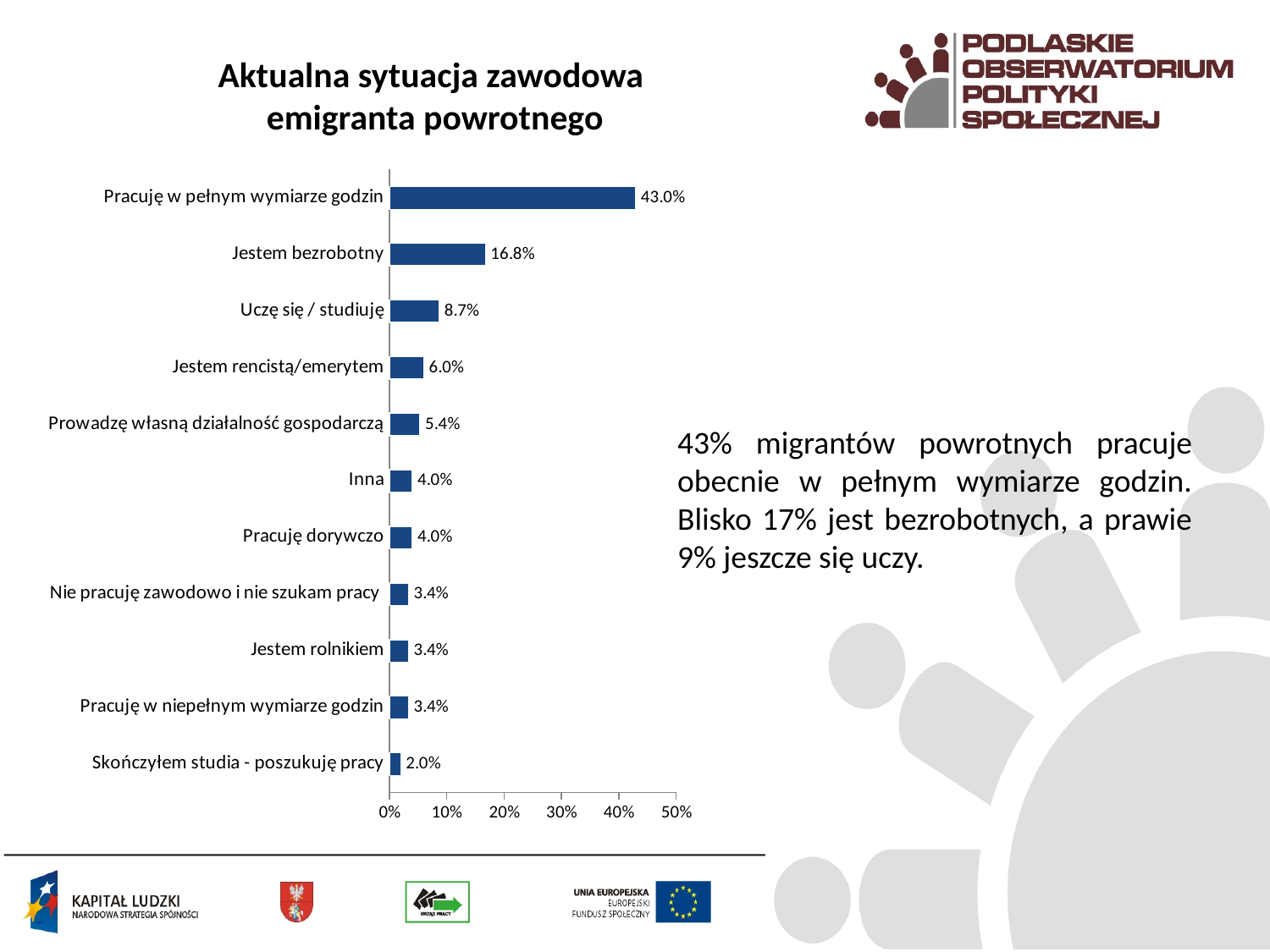
What is the value for "Prowadzę własną działalność gospodarczą"? 5.4% Is the value for "Jestem bezrobotny" greater or less than 20%? less What is the value for "Uczę się / studiuję"? 8.7% What is the value for "Jestem bezrobotny"? 16.8% What kind of chart is shown on the slide? Bar chart Which is larger, the value for "Jestem rencistą/emerytem" or the value for "Uczę się / studiuję"? Uczę się / studiuję Which category has the highest value? Pracuję w pełnym wymiarze godzin What is the difference between the values for "Pracuję w pełnym wymiarze godzin" and "Jestem bezrobotny"? 26.2 percentage points How many categories are shown in the chart? 11 What is the title of the chart? Aktualna sytuacja zawodowa emigranta powrotnego Which category has the lowest value? Skończyłem studia - poszukuję pracy What is the value for "Pracuję w pełnym wymiarze godzin"? 43.0%